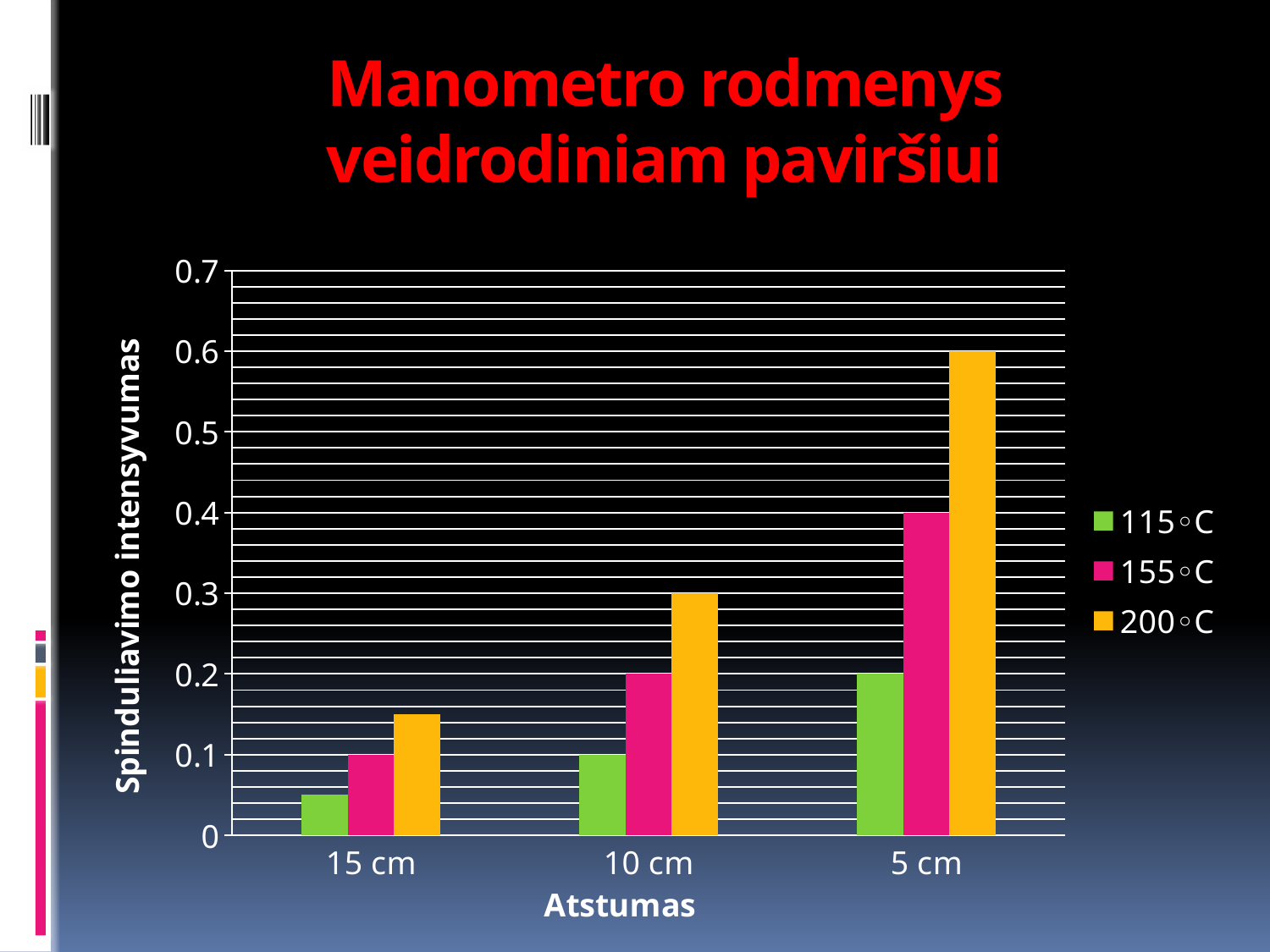
How many distance categories are shown on the x axis? 3 How many series does the legend list? 3 Which distance has the lowest value for the 115°C series? 15 cm What is the value for 115°C at 5 cm? 0.2 What is the value for 155°C at 10 cm? 0.2 Which distance has the highest value for the 200°C series? 5 cm What is the value for 200°C at 10 cm? 0.3 What type of chart is shown on the slide? bar chart What is the value for 200°C at 5 cm? 0.6 Is the value for 115°C at 15 cm greater or less than 0.1? less What is the difference between the 200°C and 155°C values at 5 cm? 0.2 Do the values for the 155°C series rise or fall from 15 cm to 5 cm along the x axis? rise